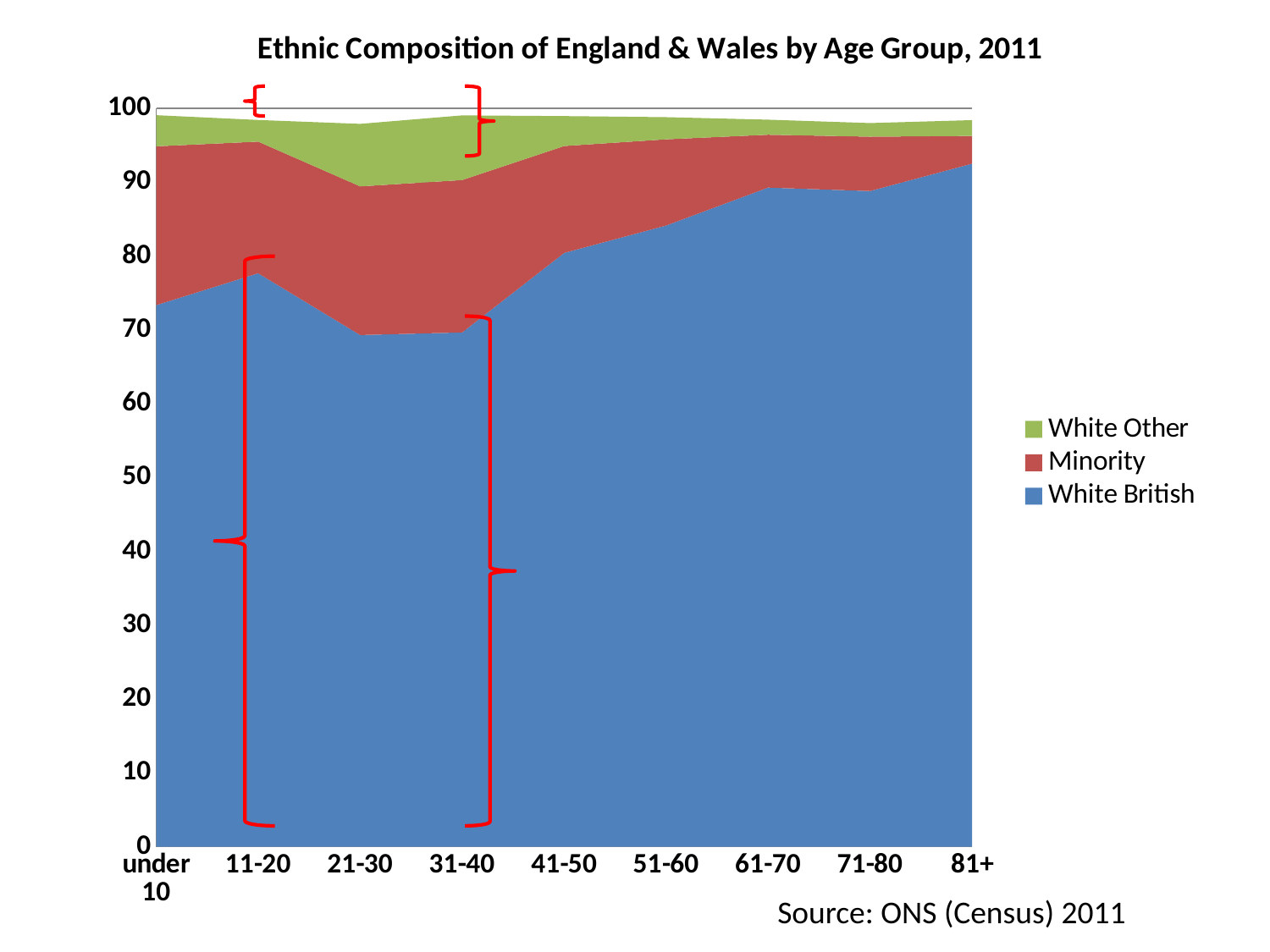
Is the White British value for the 11-20 age group greater or less than 80? less How many series does the legend list? 3 Which series is shown in green? White Other Does the White British share rise or fall from the 31-40 age group to the 81+ age group? rise Which is larger, the White British share for 81+ or for 21-30? 81+ Is the White British value for the under 10 age group greater or less than 70? greater Is the White British value for the 51-60 age group greater or less than 80? greater Which age group has the highest White British share? 81+ How many age groups are shown along the x axis? 9 What kind of chart is shown on the slide? Stacked area chart What is the title of the chart? Ethnic Composition of England & Wales by Age Group, 2011